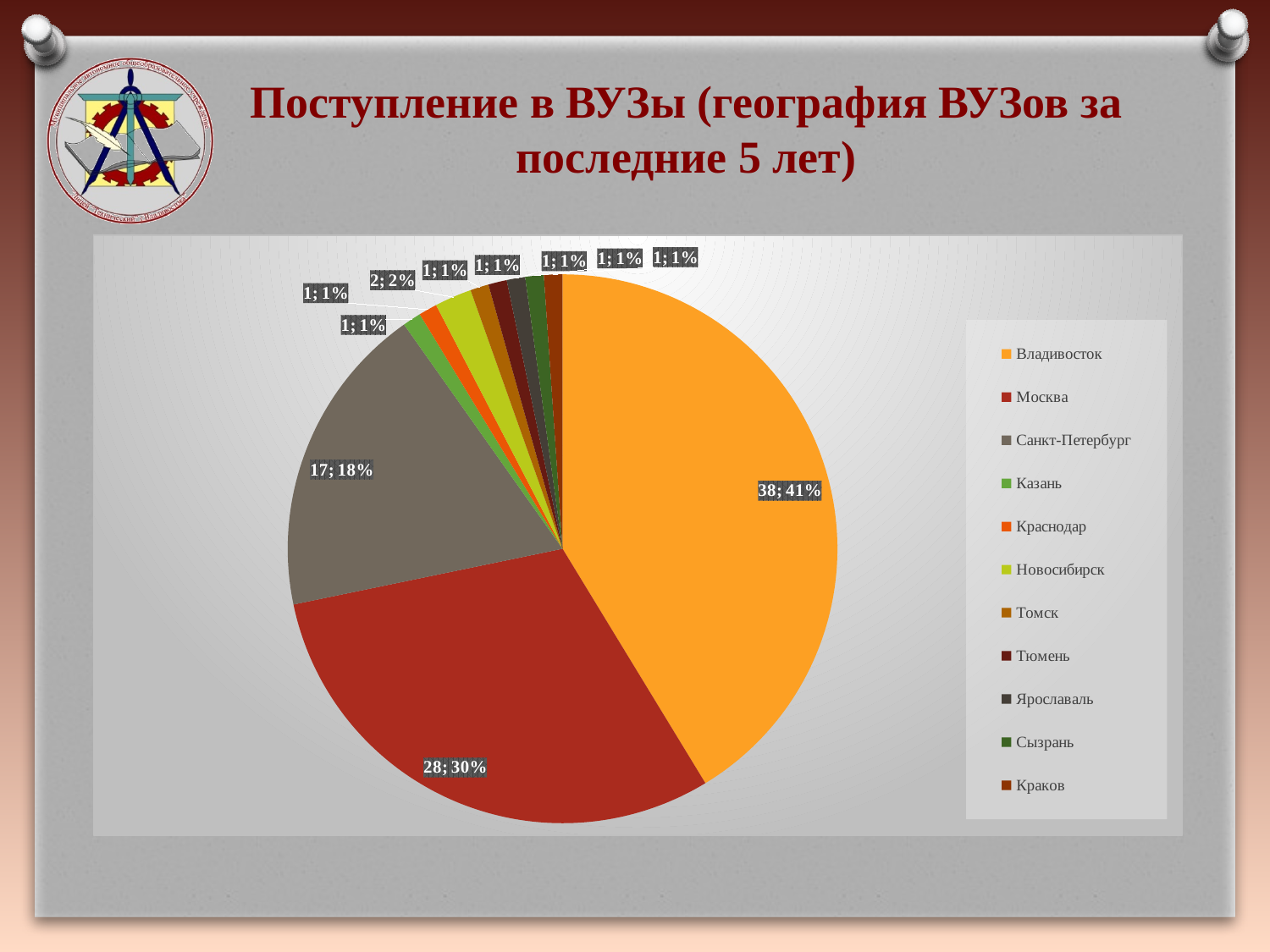
What is the difference between the values for Владивосток and Москва? 10 How many categories (cities) does the pie chart show? 11 What kind of chart is shown on the slide? pie chart Which is larger, the value for Москва or the value for Санкт-Петербург? Москва What is the value for Владивосток in the pie chart? 38 What share of the pie does Владивосток have? 41% What share of the pie does Санкт-Петербург have? 18% What is the value for Санкт-Петербург in the pie chart? 17 What share of the pie does Москва have? 30% What is the value for Москва in the pie chart? 28 Which city has the largest slice of the pie chart? Владивосток What is the value for Новосибирск in the pie chart? 2